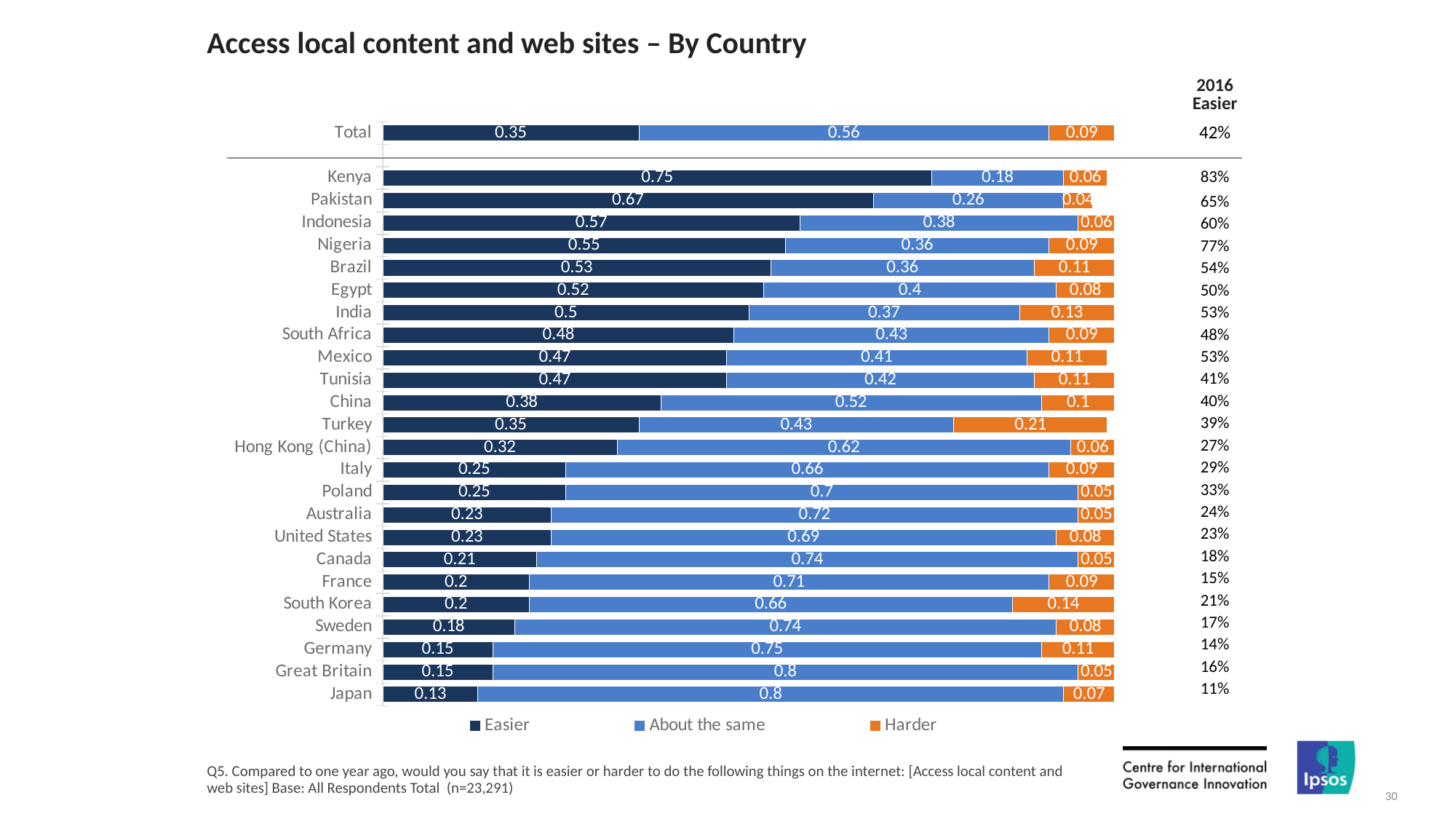
What is the 'Harder' value for Turkey? 0.21 Which is larger, the 'Easier' value for China or for Turkey? China What is the 'About the same' value for Japan? 0.8 How many countries (excluding Total) are listed on the chart? 24 What is the title of the chart? Access local content and web sites – By Country Which country has the lowest 'Easier' value? Japan What is the 'Harder' value for the Total row? 0.09 What is the difference between the 'Easier' values for Kenya and Pakistan? 0.08 What kind of chart is shown on the slide? Stacked bar chart How many series does the legend list? 3 What is the 'Easier' value for Kenya? 0.75 Which country has the highest 'Easier' value? Kenya